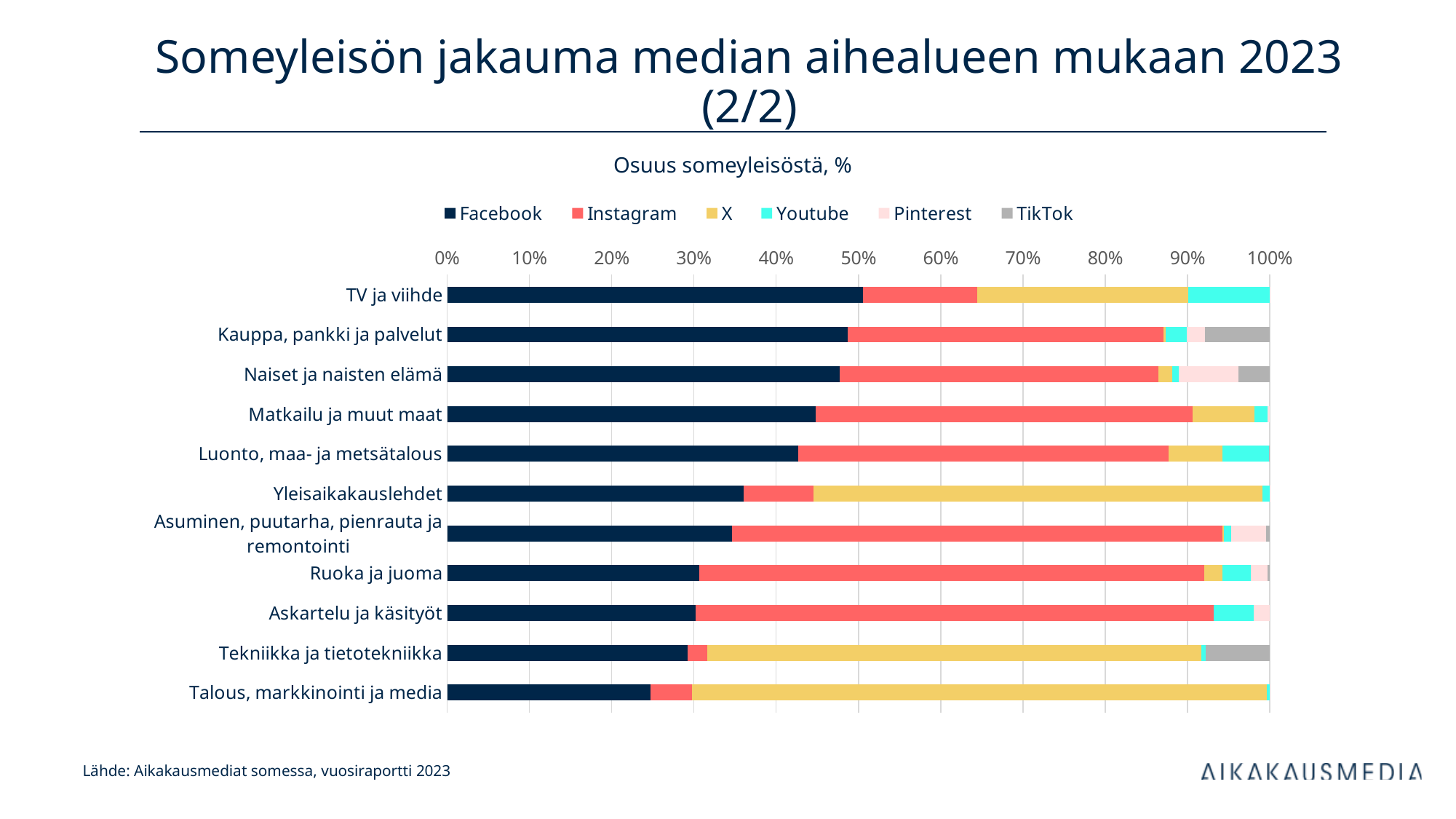
Going from the top category to the bottom category, do the Facebook segments get longer or shorter? shorter Is the Facebook share for Luonto, maa- ja metsätalous greater or less than 40%? greater Which category has the smallest Facebook share? Talous, markkinointi ja media Is the Facebook share for Talous, markkinointi ja media greater or less than 30%? less Which has a larger Facebook share, Matkailu ja muut maat or Ruoka ja juoma? Matkailu ja muut maat How many media topic categories are plotted on the chart? 11 Which has a larger Instagram share, Askartelu ja käsityöt or Tekniikka ja tietotekniikka? Askartelu ja käsityöt How many series does the legend list? 6 Is the Facebook share for Yleisaikakauslehdet greater or less than 40%? less What kind of chart is shown on the slide? Stacked bar chart What is the subtitle shown above the legend of the chart? Osuus someyleisöstä, % Which category has the largest X share? Talous, markkinointi ja media